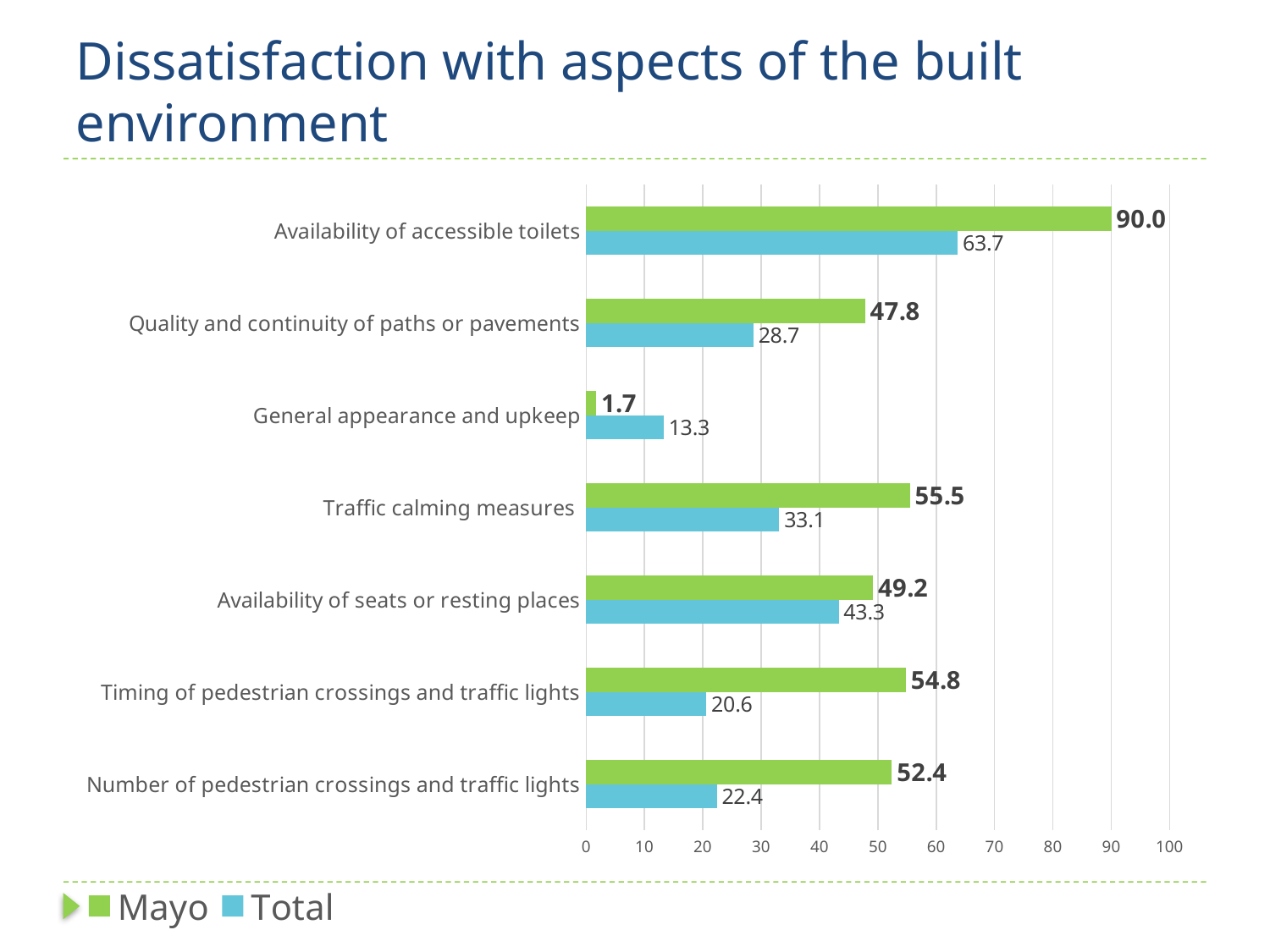
How many categories are shown on the chart? 7 Which colour represents the Mayo series? Green What is the Total value for General appearance and upkeep? 13.3 What kind of chart is shown on the slide? Bar chart Which category has the lowest Total value? General appearance and upkeep Which category has the highest Mayo value? Availability of accessible toilets Which category has the lowest Mayo value? General appearance and upkeep How many series does the legend list? 2 What is the Total value for Timing of pedestrian crossings and traffic lights? 20.6 What is the Mayo value for Availability of accessible toilets? 90.0 What is the difference between the Mayo and Total values for Traffic calming measures? 22.4 Which is larger for General appearance and upkeep, the Mayo value or the Total value? Total